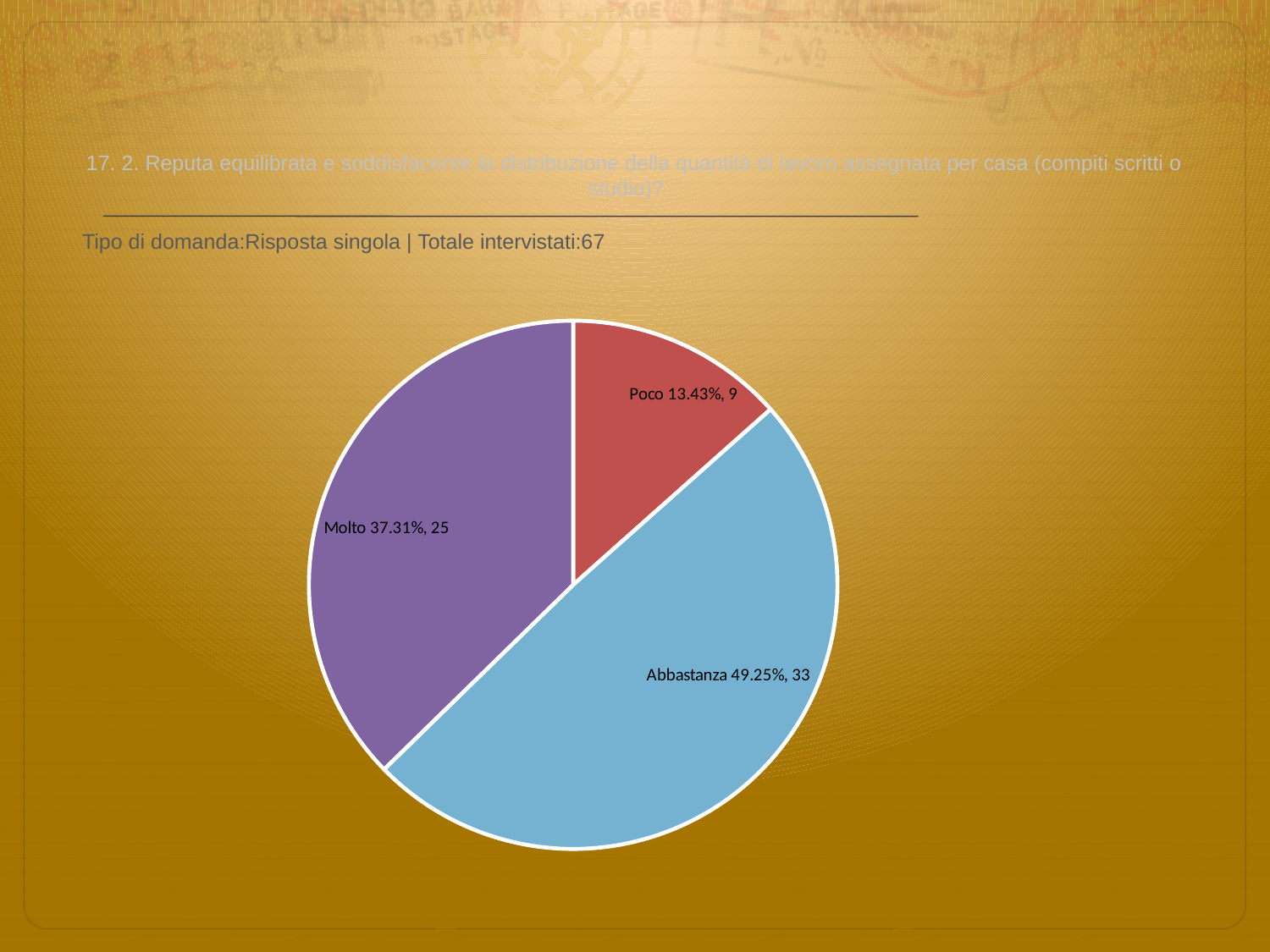
Which has more respondents, Molto or Poco? Molto What colour is the Abbastanza slice? light blue What is the difference in respondent count between Abbastanza and Molto? 8 What is the total number of respondents across all slices? 67 How many slices does the pie chart have? 3 How many respondents answered Poco? 9 How many respondents answered Molto? 25 What kind of chart is shown on the slide? pie chart Which category has the largest share of the pie? Abbastanza Which category has the smallest share of the pie? Poco What percentage is shown for the Poco slice? 13.43% What percentage is shown for the Abbastanza slice? 49.25%